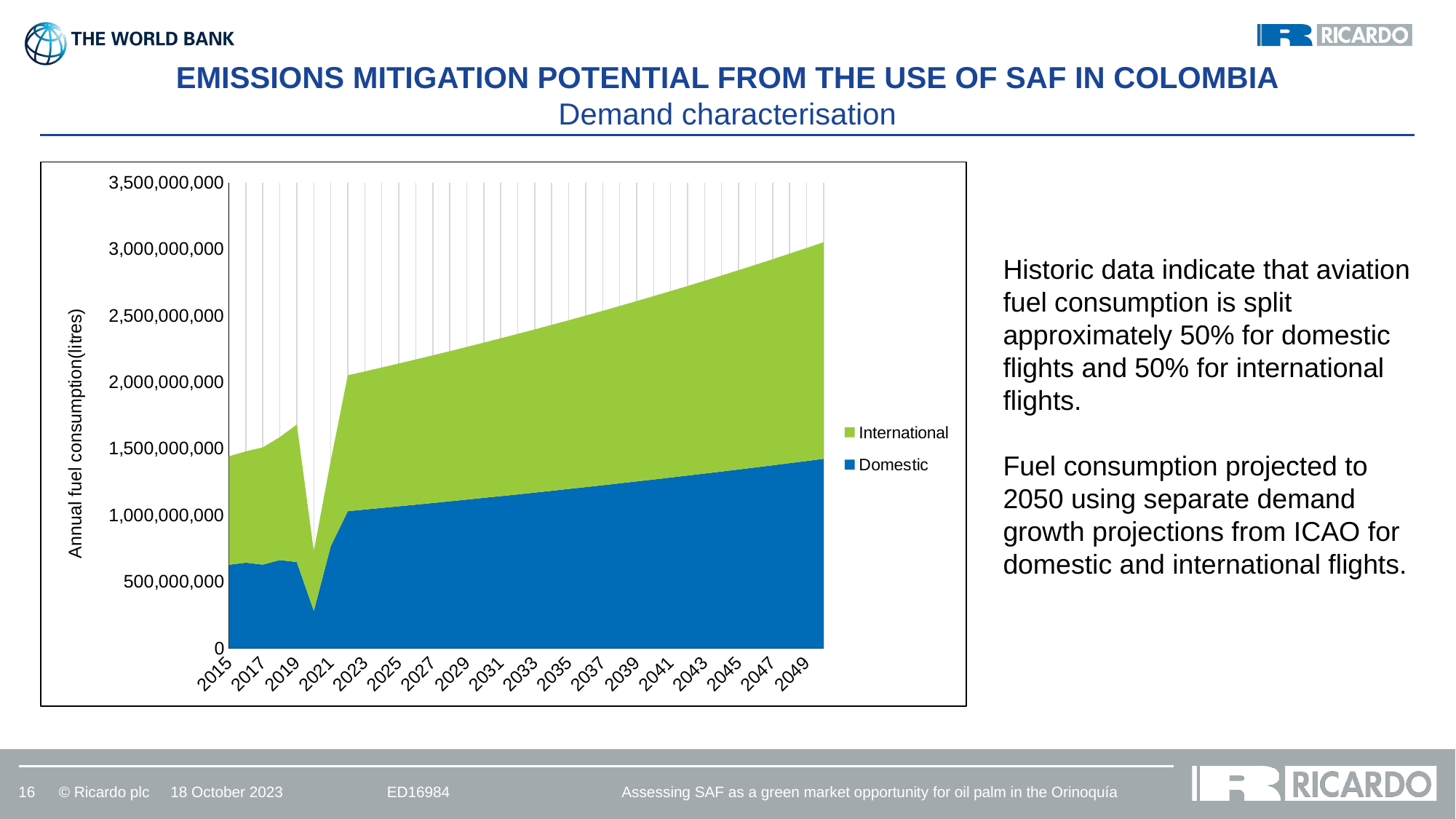
Does the Domestic fuel consumption rise or fall from 2023 to 2049? Rises What is the label on the vertical axis of the chart? Annual fuel consumption(litres) Is the Domestic fuel consumption in 2049 greater or less than 1,500,000,000 litres? less Is the total annual fuel consumption in 2021 greater or less than 1,000,000,000 litres? greater What are the two series named in the chart legend? International and Domestic How many year labels are shown on the x axis of the chart? 18 What kind of chart is shown on the slide? Stacked area chart In which year does total annual fuel consumption reach its lowest point in the chart? 2020 How many series does the chart legend list? 2 Is the Domestic fuel consumption in 2015 greater or less than 500,000,000 litres? greater Which colour represents the Domestic series in the chart? Blue